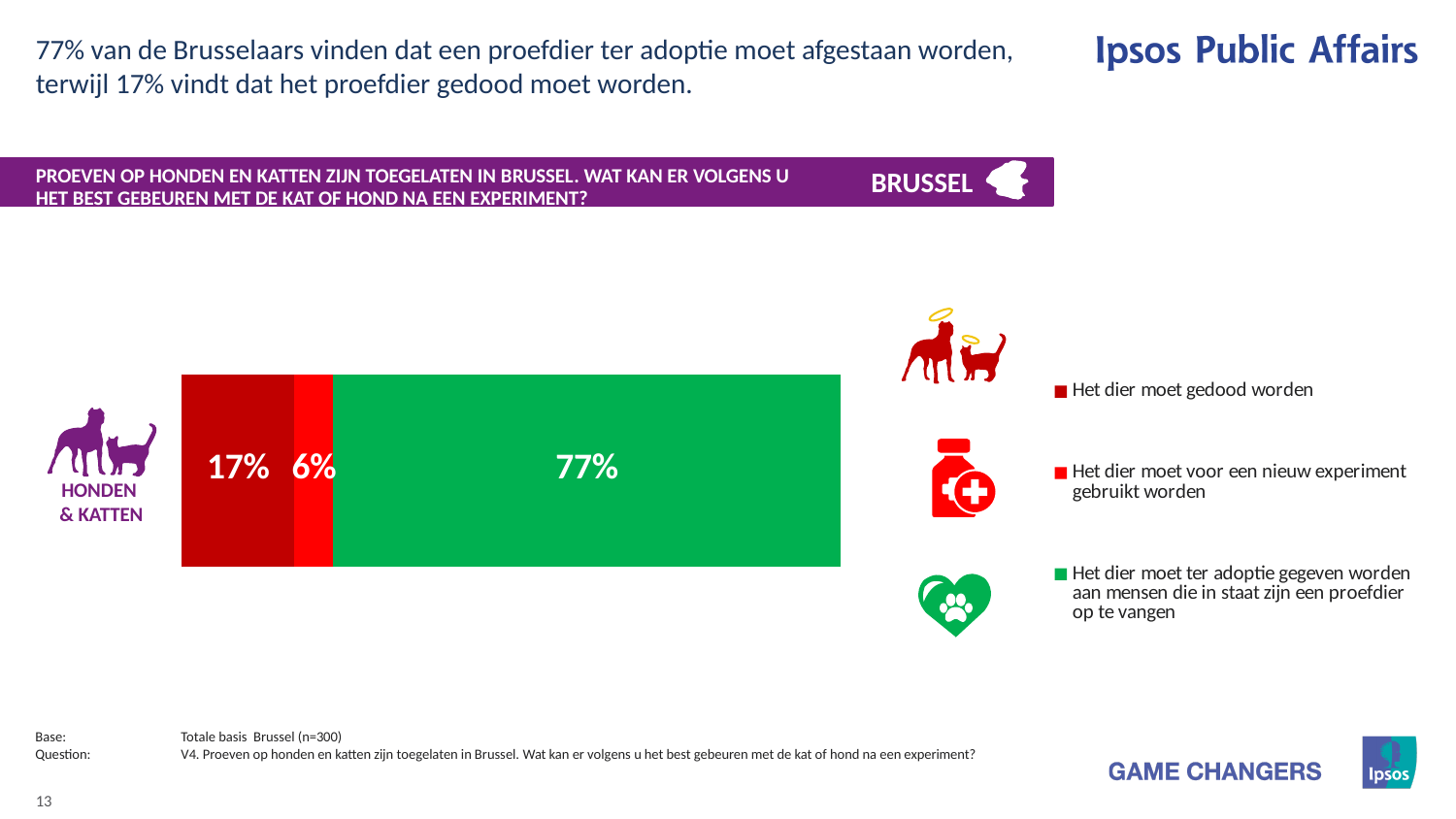
What percentage of respondents say the animal should be put up for adoption ("Het dier moet ter adoptie gegeven worden")? 77% How many series does the legend list? 3 What kind of chart is shown on the slide? Stacked bar chart What is the total of the three segments in the stacked bar? 100% What is the difference in percentage points between the killed share and the new-experiment share? 11 What colour is the segment for "Het dier moet ter adoptie gegeven worden"? Green What percentage of respondents say the animal should be killed ("Het dier moet gedood worden")? 17% What is the difference in percentage points between the adoption share and the killed share? 60 Which response option has the largest share in the bar? Het dier moet ter adoptie gegeven worden aan mensen die in staat zijn een proefdier op te vangen Which is larger: the share for "Het dier moet gedood worden" or the share for "Het dier moet voor een nieuw experiment gebruikt worden"? Het dier moet gedood worden What percentage of respondents say the animal should be used for a new experiment ("Het dier moet voor een nieuw experiment gebruikt worden")? 6% Which response option has the smallest share in the bar? Het dier moet voor een nieuw experiment gebruikt worden